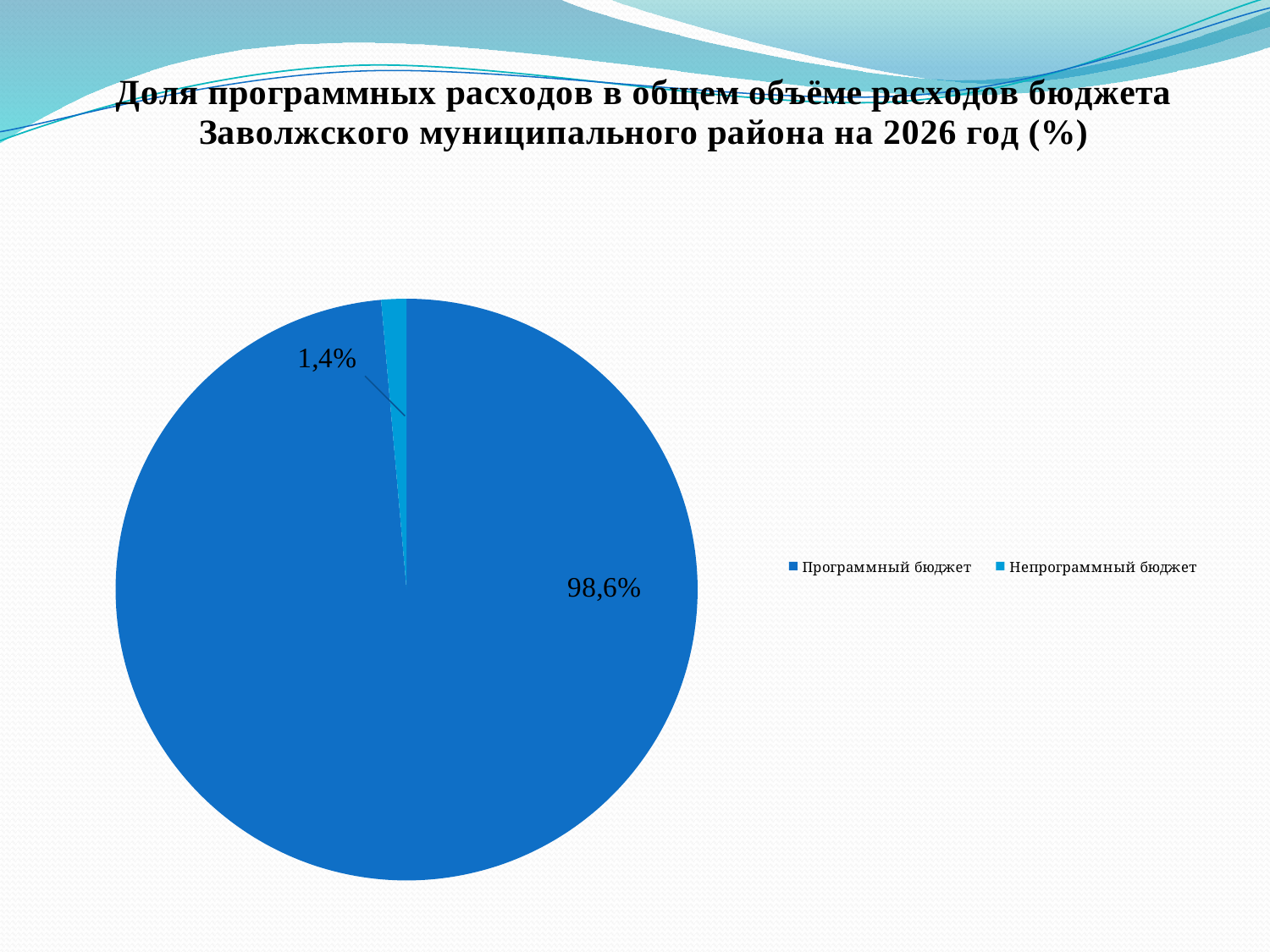
What kind of chart is shown on the slide? pie chart Which category has the largest share of the pie? Программный бюджет Which category has the smallest share of the pie? Непрограммный бюджет What is the difference between the values for Программный бюджет and Непрограммный бюджет? 97,2% How many entries does the legend list? 2 What is the value for Непрограммный бюджет? 1,4% Which is larger: Программный бюджет or Непрограммный бюджет? Программный бюджет What is the value for Программный бюджет? 98,6% How many slices does the pie chart have? 2 Which year does the chart title refer to? 2026 What is the title of the chart? Доля программных расходов в общем объёме расходов бюджета Заволжского муниципального района на 2026 год (%)